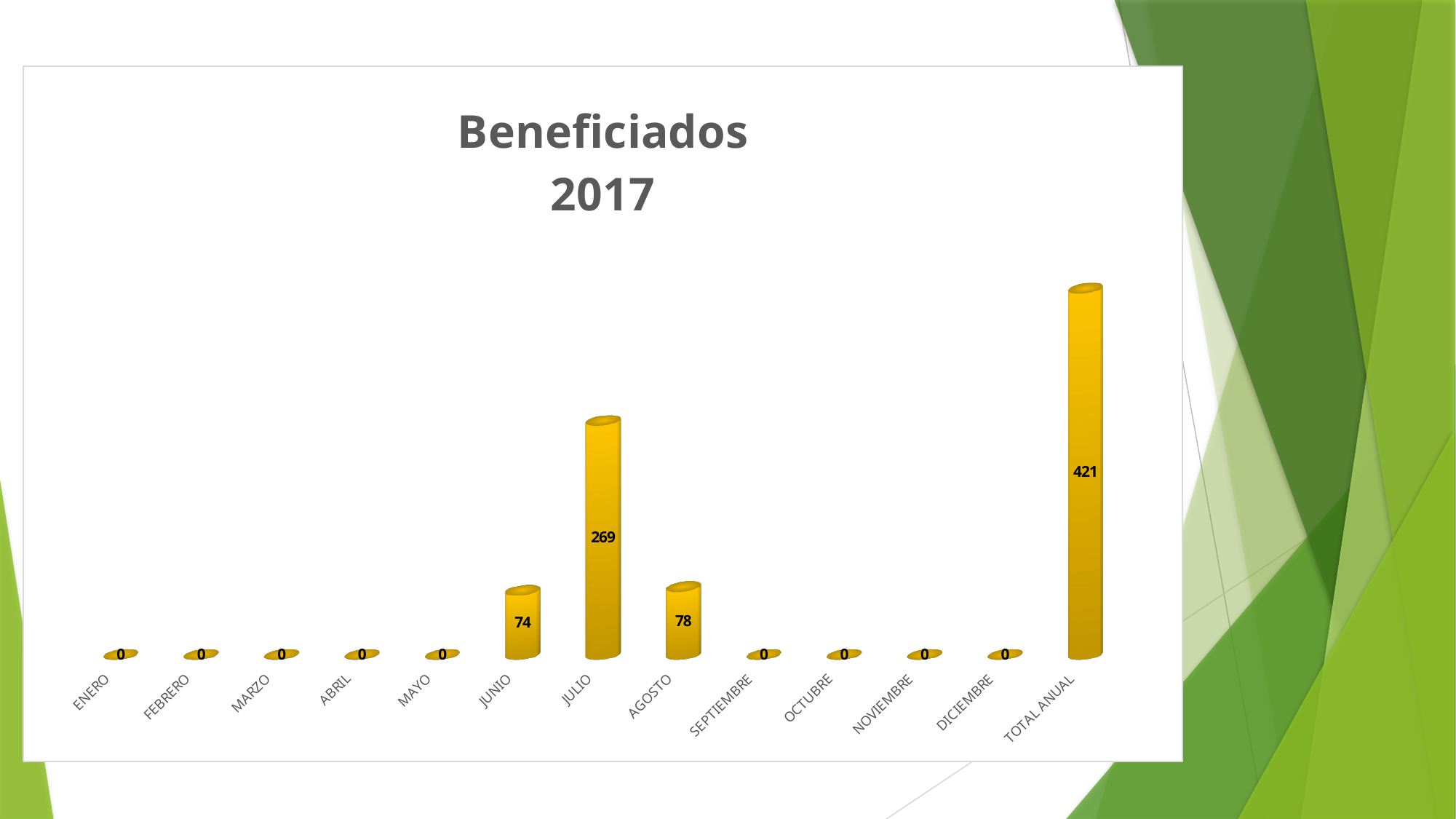
What is the title of the chart? Beneficiados 2017 Which is larger, the value for JULIO or the value for AGOSTO? JULIO What is the difference between the values for AGOSTO and JUNIO? 4 What is the value for JULIO? 269 What is the difference between the values for JULIO and JUNIO? 195 Which month (excluding TOTAL ANUAL) has the highest value? JULIO What is the value for TOTAL ANUAL? 421 What is the value for JUNIO? 74 How many categories are shown on the x axis? 13 What is the value for AGOSTO? 78 What kind of chart is this? bar chart What is the value for ENERO? 0